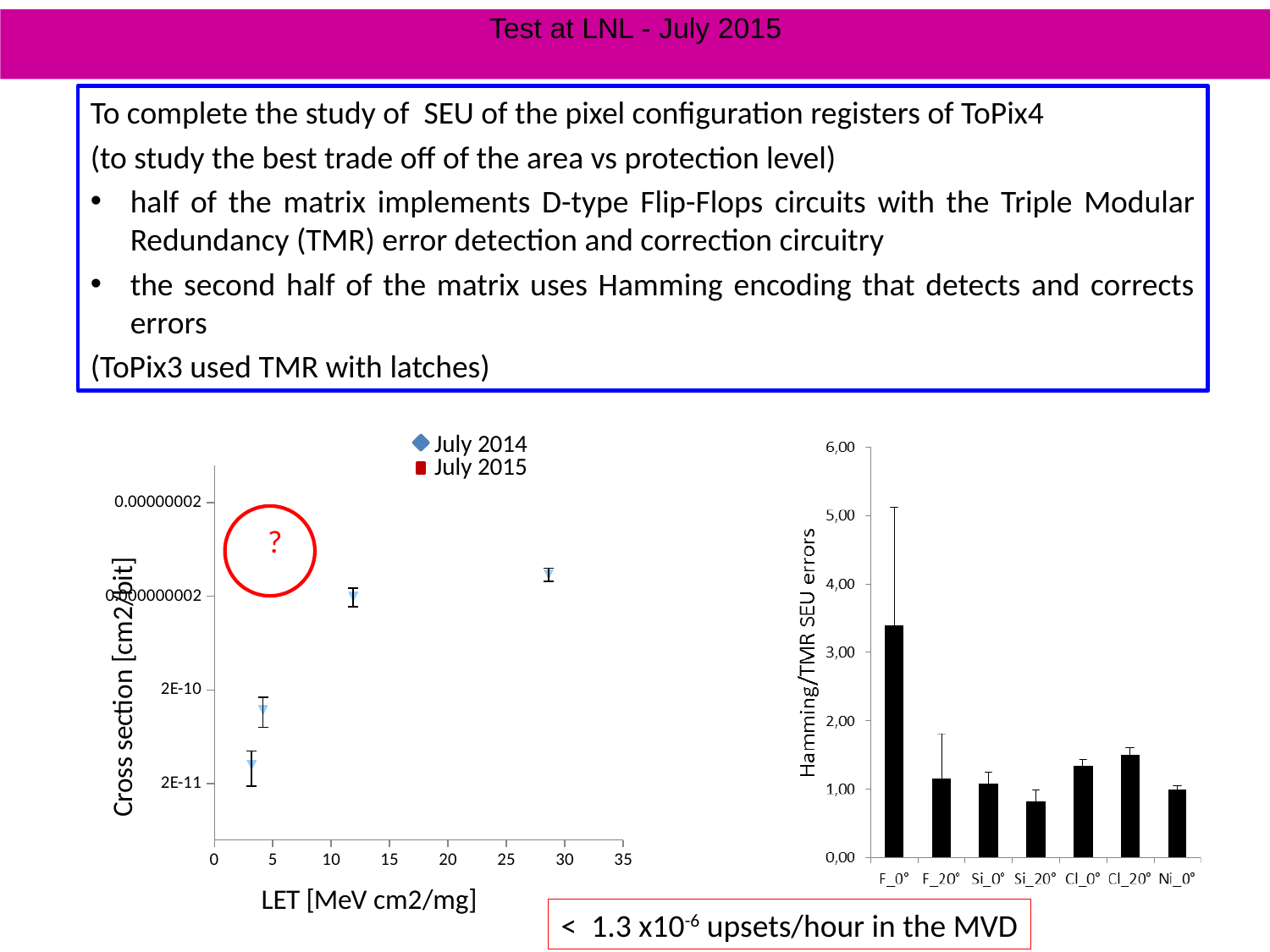
In the bar chart on the right, which is larger, the value for F_0° or the value for F_20°? F_0° In the scatter chart on the left, does the cross section rise or fall as LET increases? rise In the bar chart on the right, which category has the highest value? F_0° In the scatter chart on the left, what is the label of the horizontal axis? LET [MeV cm2/mg] In the bar chart on the right, is the value for Si_20° greater or less than 1,00? less In the bar chart on the right, is the value for Cl_20° greater or less than 1,00? greater In the bar chart on the right, how many categories are shown on the x axis? 7 What kind of chart is the chart on the left of the slide? scatter chart What kind of chart is the chart on the right of the slide? bar chart In the bar chart on the right, what is the label of the vertical axis? Hamming/TMR SEU errors In the scatter chart on the left, how many series does the legend list? 2 In the bar chart on the right, is the value for F_0° greater or less than 3,00? greater